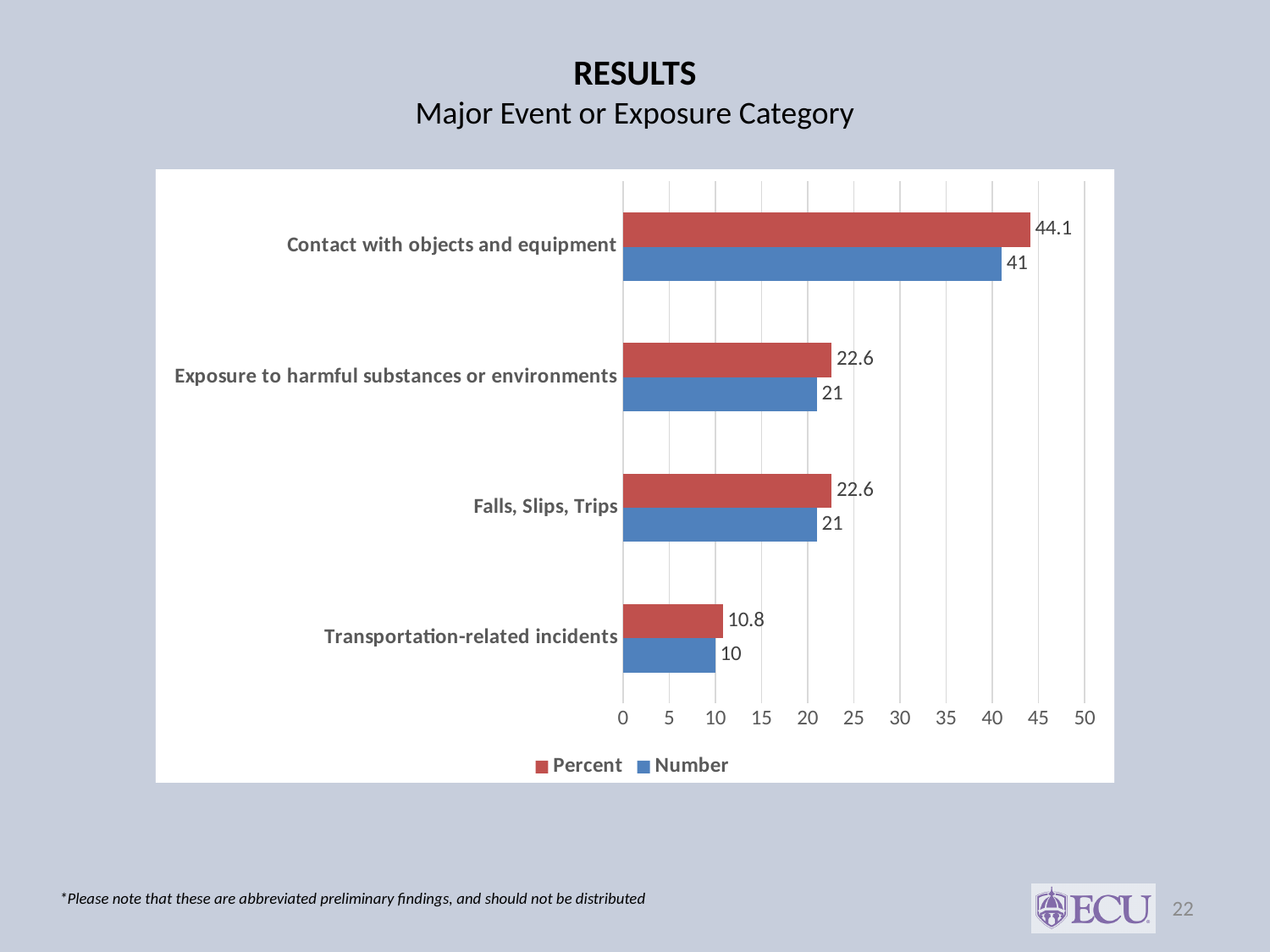
What kind of chart is shown on the slide? Bar chart What is the difference between the Percent values for Contact with objects and equipment and Falls, Slips, Trips? 21.5 Which category has the lowest Percent value? Transportation-related incidents Which colour represents the Number series in the legend? Blue Which category has the highest Number value? Contact with objects and equipment Which is larger: the Percent value for Falls, Slips, Trips or the Percent value for Transportation-related incidents? Falls, Slips, Trips How many series does the legend list? 2 What is the Number value for Exposure to harmful substances or environments? 21 What is the Number value for Transportation-related incidents? 10 What is the Percent value for Contact with objects and equipment? 44.1 How many categories are shown on the chart? 4 What is the difference between the Number values for Contact with objects and equipment and Transportation-related incidents? 31